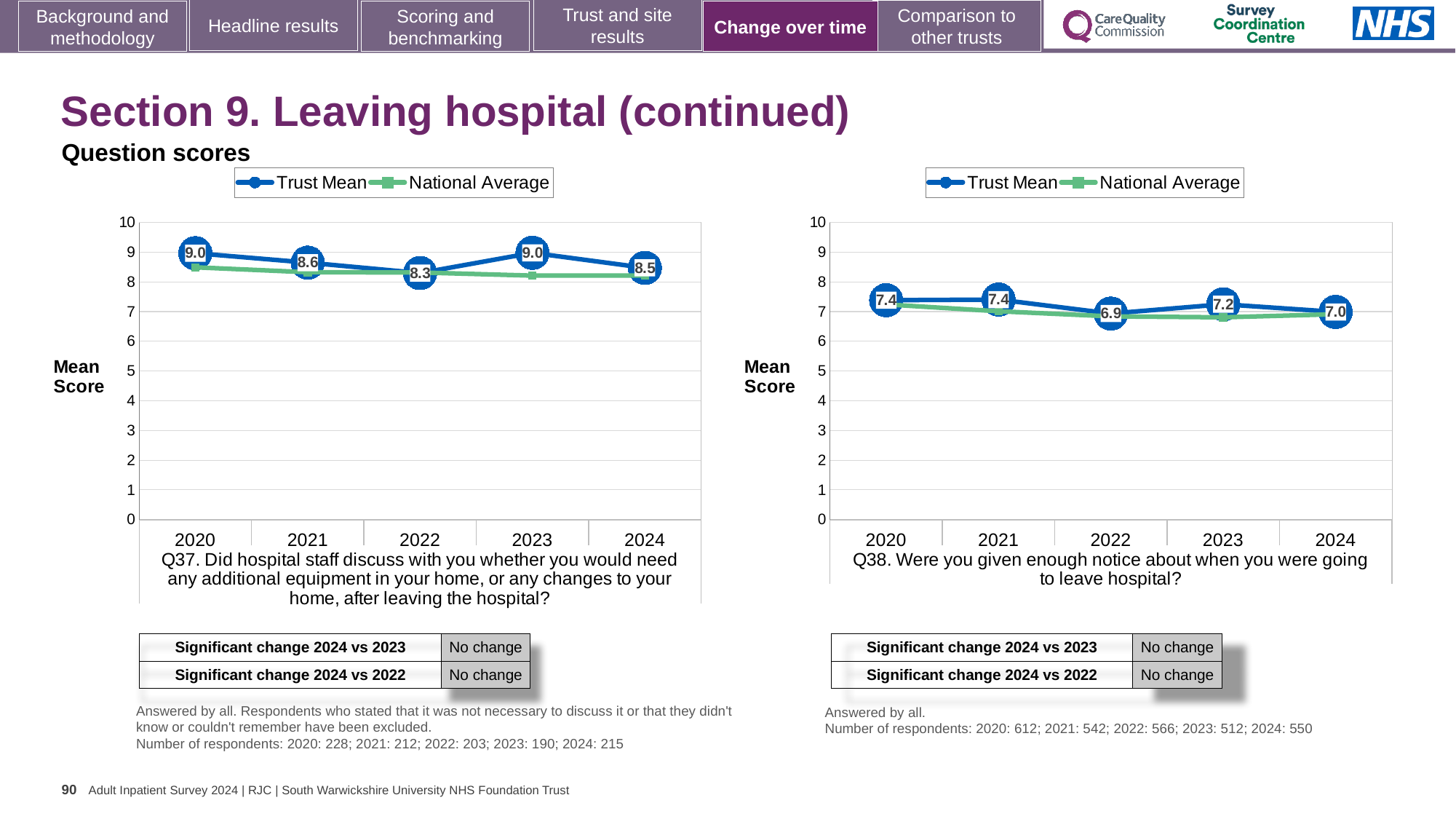
In the Q37 chart on the left, what is the Trust Mean score for 2022? 8.3 In the Q37 chart on the left, is the Trust Mean score higher in 2023 or in 2024? 2023 How many years are shown on the x axis of the Q38 chart on the right? 5 In the Q37 chart on the left, what is the difference between the Trust Mean scores for 2020 and 2022? 0.7 In the Q38 chart on the right, what is the difference between the Trust Mean scores for 2021 and 2022? 0.5 How many series does the legend of the Q37 chart on the left list? 2 What type of chart is used for the Q38 chart on the right? Line chart In the Q38 chart on the right, what is the Trust Mean score for 2024? 7.0 In the Q38 chart on the right, which year has the lowest Trust Mean score? 2022 In the Q37 chart on the left, is the National Average value for 2020 greater or less than 8? greater In the Q37 chart on the left, which year has the lowest Trust Mean score? 2022 In the Q38 chart on the right, is the National Average value for 2022 greater or less than 6? greater